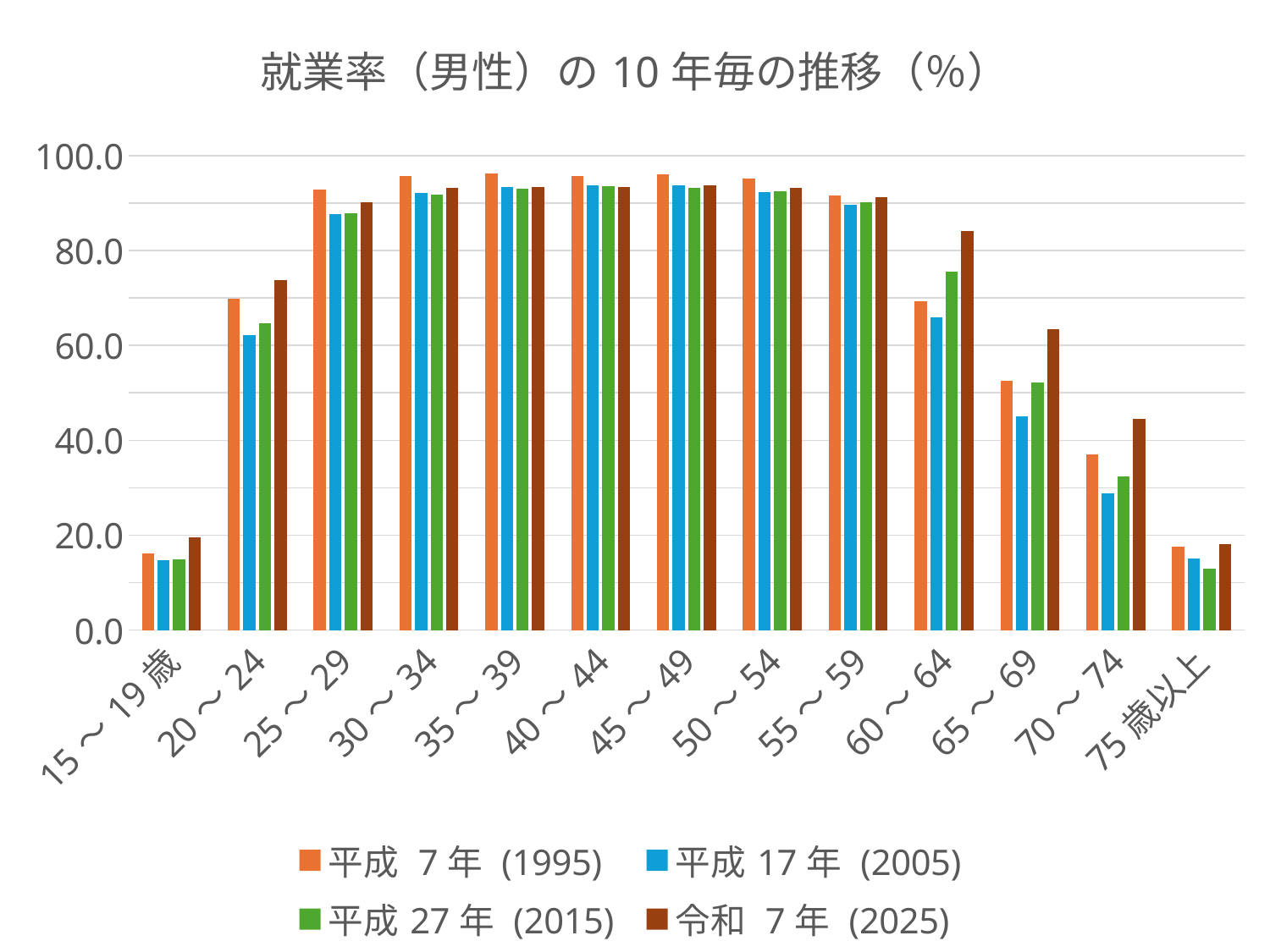
What kind of chart is shown on the slide? Bar chart For the 15～19歳 age group, which is larger: 令和 7年 (2025) or 平成 7年 (1995)? 令和 7年 (2025) What is the title of the chart? 就業率（男性）の10年毎の推移（%） How many series does the legend list? 4 For the 60～64 age group, which is larger: 令和 7年 (2025) or 平成 7年 (1995)? 令和 7年 (2025) From the 45～49 age group to the 75歳以上 age group, do the values rise or fall? fall Is the value for 70～74 in 平成 17年 (2005) greater or less than 40.0? less In the 70～74 age group, which series has the highest value? 令和 7年 (2025) Is the value for 65～69 in 平成 17年 (2005) greater or less than 50.0? less How many age-group categories are shown on the x axis? 13 Is the value for 60～64 in 令和 7年 (2025) greater or less than 80.0? greater In the 65～69 age group, which series has the lowest value? 平成 17年 (2005)